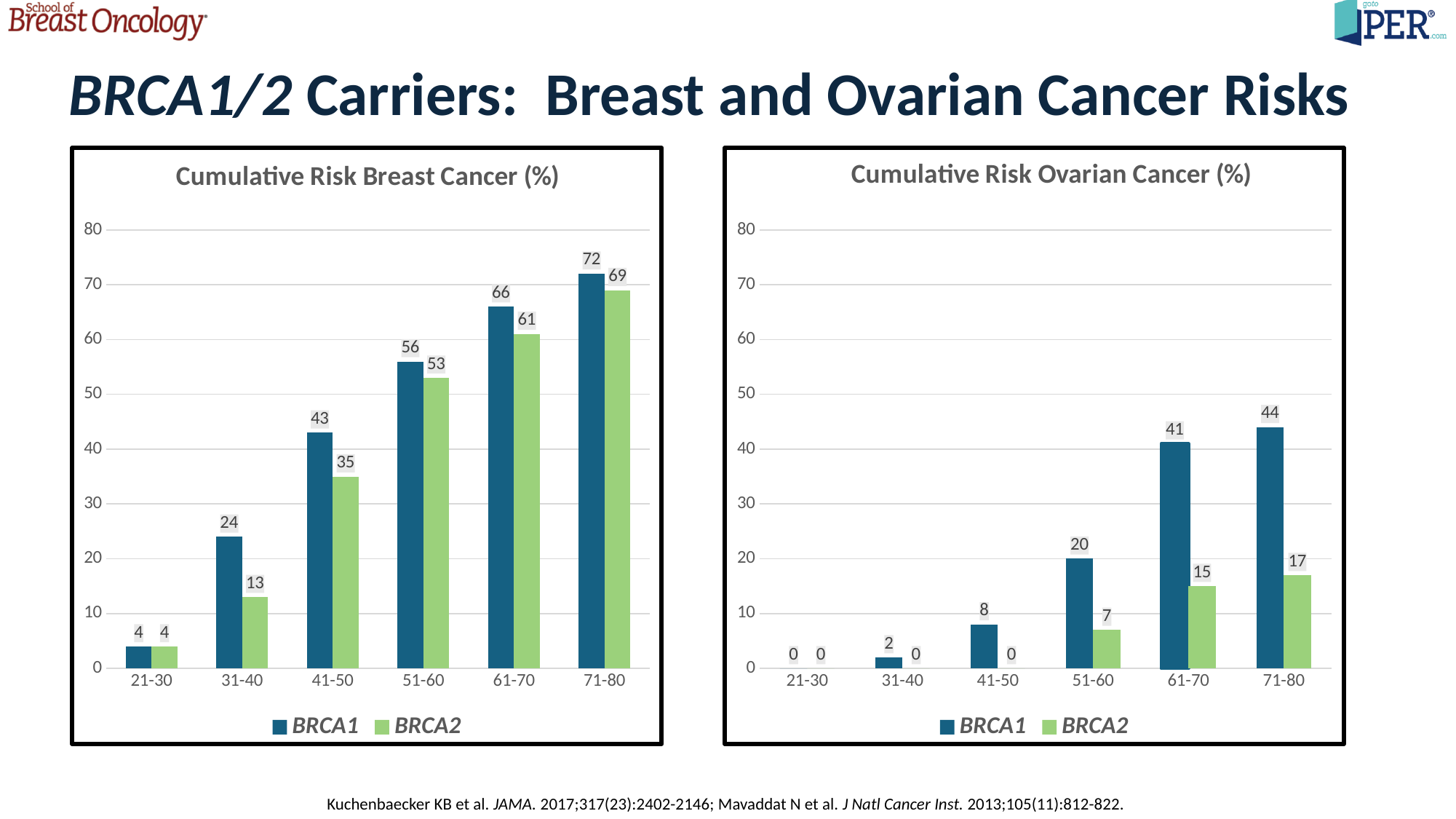
How many age groups are shown on the x axis of the Cumulative Risk Ovarian Cancer (%) chart? 6 In the Cumulative Risk Breast Cancer (%) chart, do the BRCA1 values rise or fall as the age groups increase along the x axis? Rise In the Cumulative Risk Breast Cancer (%) chart, is the BRCA2 value for the 51-60 age group greater or less than 50? greater In the Cumulative Risk Breast Cancer (%) chart, what is the difference between the BRCA1 and BRCA2 values for the 31-40 age group? 11 In the Cumulative Risk Ovarian Cancer (%) chart, which age group has the lowest BRCA1 value? 21-30 In the Cumulative Risk Breast Cancer (%) chart, which age group has the highest BRCA2 value? 71-80 How many series does the legend of the Cumulative Risk Breast Cancer (%) chart list? 2 In the Cumulative Risk Breast Cancer (%) chart, what is the value for BRCA1 in the 41-50 age group? 43 In the Cumulative Risk Ovarian Cancer (%) chart, which is larger for the 51-60 age group, BRCA1 or BRCA2? BRCA1 What kind of chart is the Cumulative Risk Breast Cancer (%) chart? Bar chart In the Cumulative Risk Ovarian Cancer (%) chart, what is the value for BRCA2 in the 61-70 age group? 15 In the Cumulative Risk Ovarian Cancer (%) chart, what is the difference between the BRCA1 and BRCA2 values for the 71-80 age group? 27